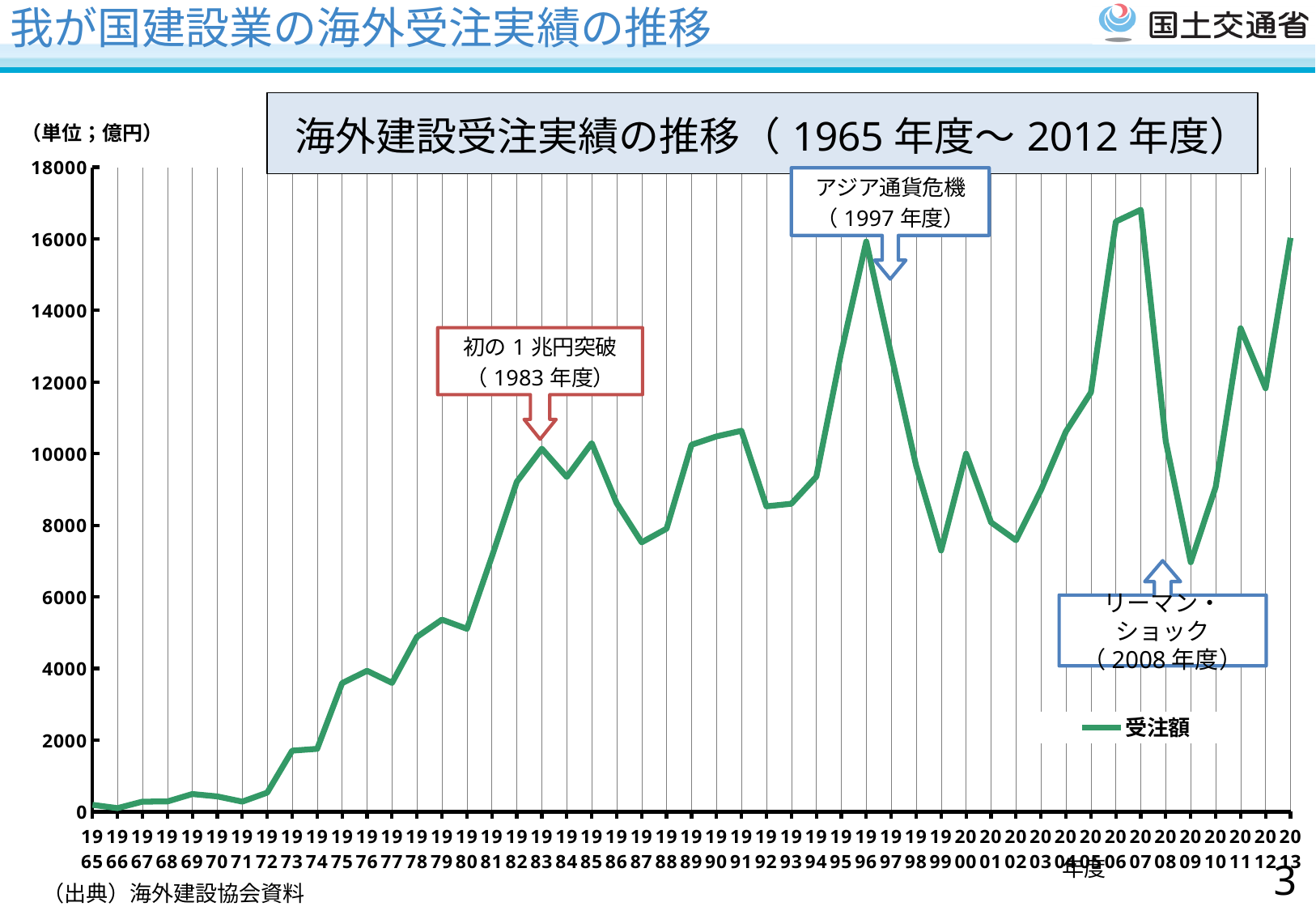
Is the value for 1973 greater or less than 2000? less Is the value for 2007 greater or less than 16000? greater What unit is given for the values on the chart? 億円 How many series does the chart legend list? 1 Is the value for 2011 greater or less than 12000? greater What is the name of the series shown in the chart legend? 受注額 Which year has the larger value, 2007 or 2009? 2007 Do the values generally rise or fall from 1972 to 1983? rise Which year has the larger value, 1996 or 1999? 1996 What kind of chart is shown on the slide? line chart